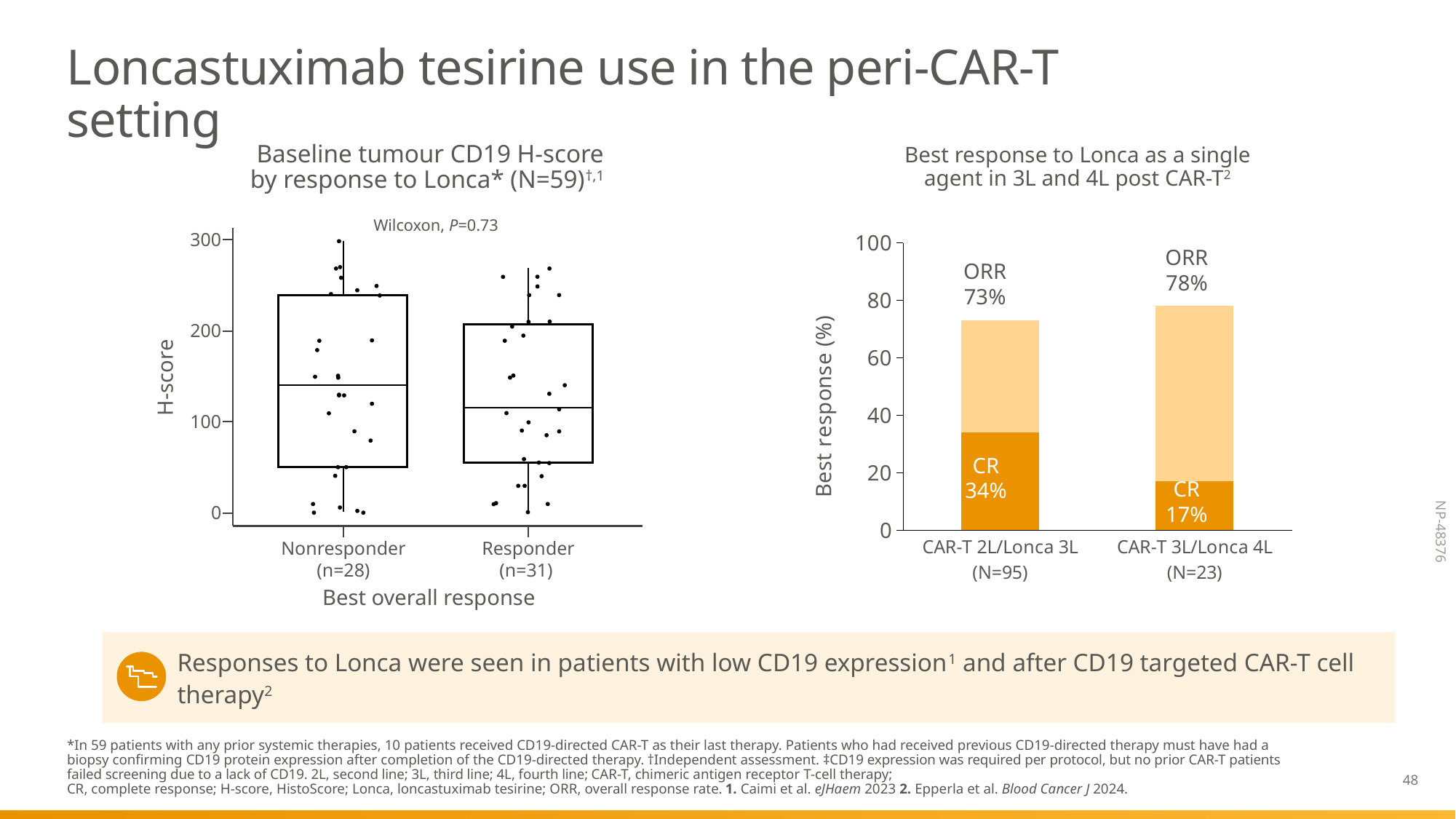
In the chart titled 'Best response to Lonca as a single agent in 3L and 4L post CAR-T', which group has the higher ORR? CAR-T 3L/Lonca 4L In the chart titled 'Best response to Lonca as a single agent in 3L and 4L post CAR-T', what is the CR rate for CAR-T 3L/Lonca 4L? 17% In the chart titled 'Best response to Lonca as a single agent in 3L and 4L post CAR-T', what is the difference in CR rate between CAR-T 2L/Lonca 3L and CAR-T 3L/Lonca 4L? 17 percentage points In the chart titled 'Baseline tumour CD19 H-score by response to Lonca', what P value is shown for the Wilcoxon test? P=0.73 In the chart titled 'Best response to Lonca as a single agent in 3L and 4L post CAR-T', how many patients are in the CAR-T 2L/Lonca 3L group? N=95 In the chart titled 'Best response to Lonca as a single agent in 3L and 4L post CAR-T', what is the difference in ORR between CAR-T 3L/Lonca 4L and CAR-T 2L/Lonca 3L? 5 percentage points In the chart titled 'Best response to Lonca as a single agent in 3L and 4L post CAR-T', how many groups are plotted on the x axis? 2 In the chart titled 'Baseline tumour CD19 H-score by response to Lonca', how many patients are in the Responder group? n=31 In the chart titled 'Best response to Lonca as a single agent in 3L and 4L post CAR-T', which group has the lower CR rate? CAR-T 3L/Lonca 4L In the chart titled 'Best response to Lonca as a single agent in 3L and 4L post CAR-T', what is the ORR for CAR-T 2L/Lonca 3L? 73% What kind of chart is the one titled 'Best response to Lonca as a single agent in 3L and 4L post CAR-T'? Stacked bar chart In the chart titled 'Baseline tumour CD19 H-score by response to Lonca', is the median H-score for Nonresponders greater or less than 100? greater